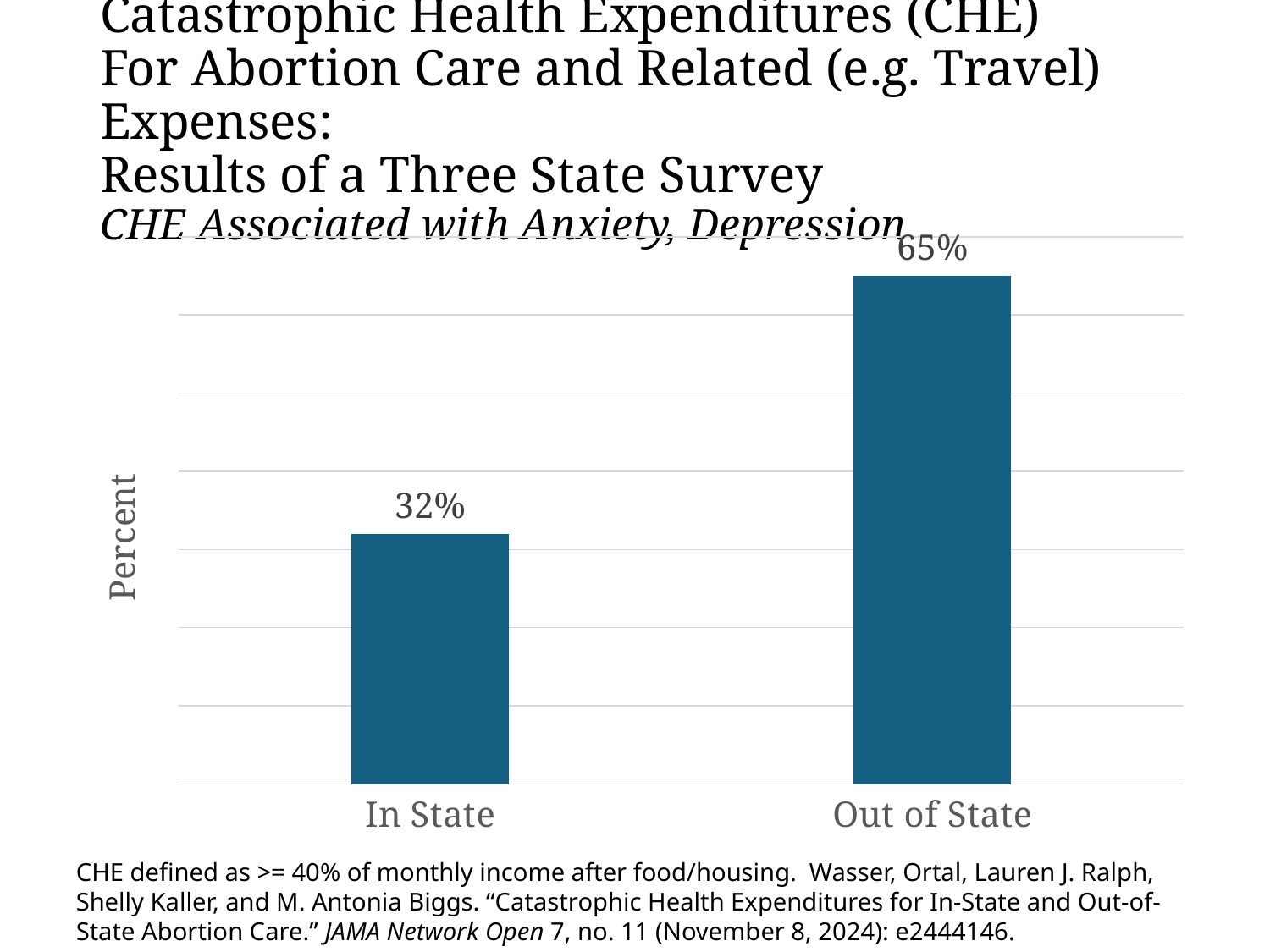
Which is larger, the value for In State or the value for Out of State? Out of State Which category has the lowest value? In State What is the value for Out of State? 65% What kind of chart is shown on the slide? Bar chart Do the values rise or fall from In State to Out of State? Rise What is the difference between the Out of State and In State values? 33% What is the value for In State? 32% What is the label of the y axis? Percent How many categories are shown on the x axis? 2 Which category has the highest value? Out of State